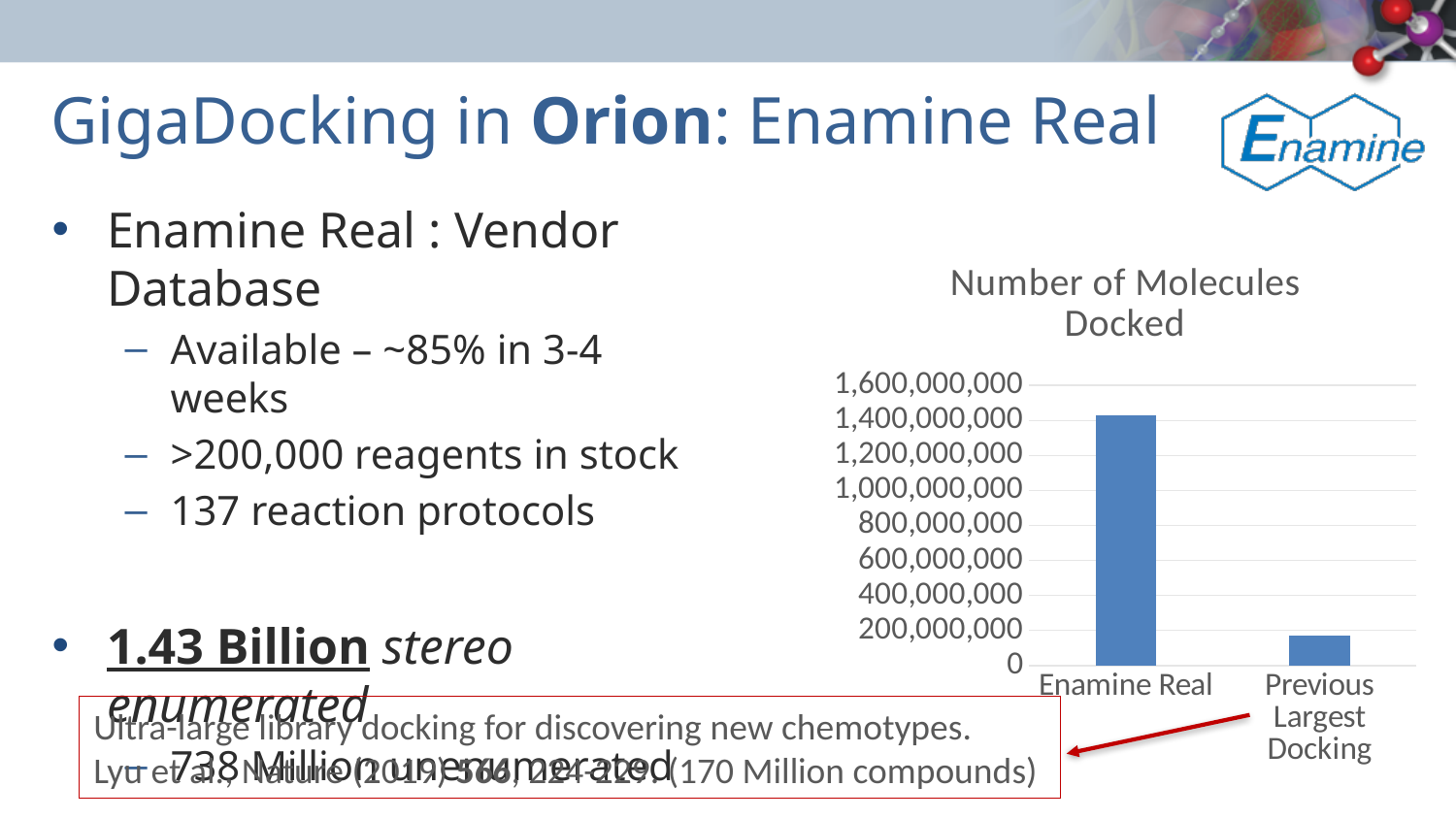
Which category has the lowest value in the chart? Previous Largest Docking Is the value for Enamine Real greater or less than 1,200,000,000? greater Which category has the highest value in the chart? Enamine Real Do the values rise or fall from left to right across the categories? fall What is the title of the chart? Number of Molecules Docked Is the value for Enamine Real greater or less than 1,600,000,000? less What is the highest value shown on the vertical axis of the chart? 1,600,000,000 What kind of chart is shown on the slide? bar chart Which is larger, the value for Enamine Real or the value for Previous Largest Docking? Enamine Real Is the value for Previous Largest Docking greater or less than 400,000,000? less How many categories are plotted in the chart? 2